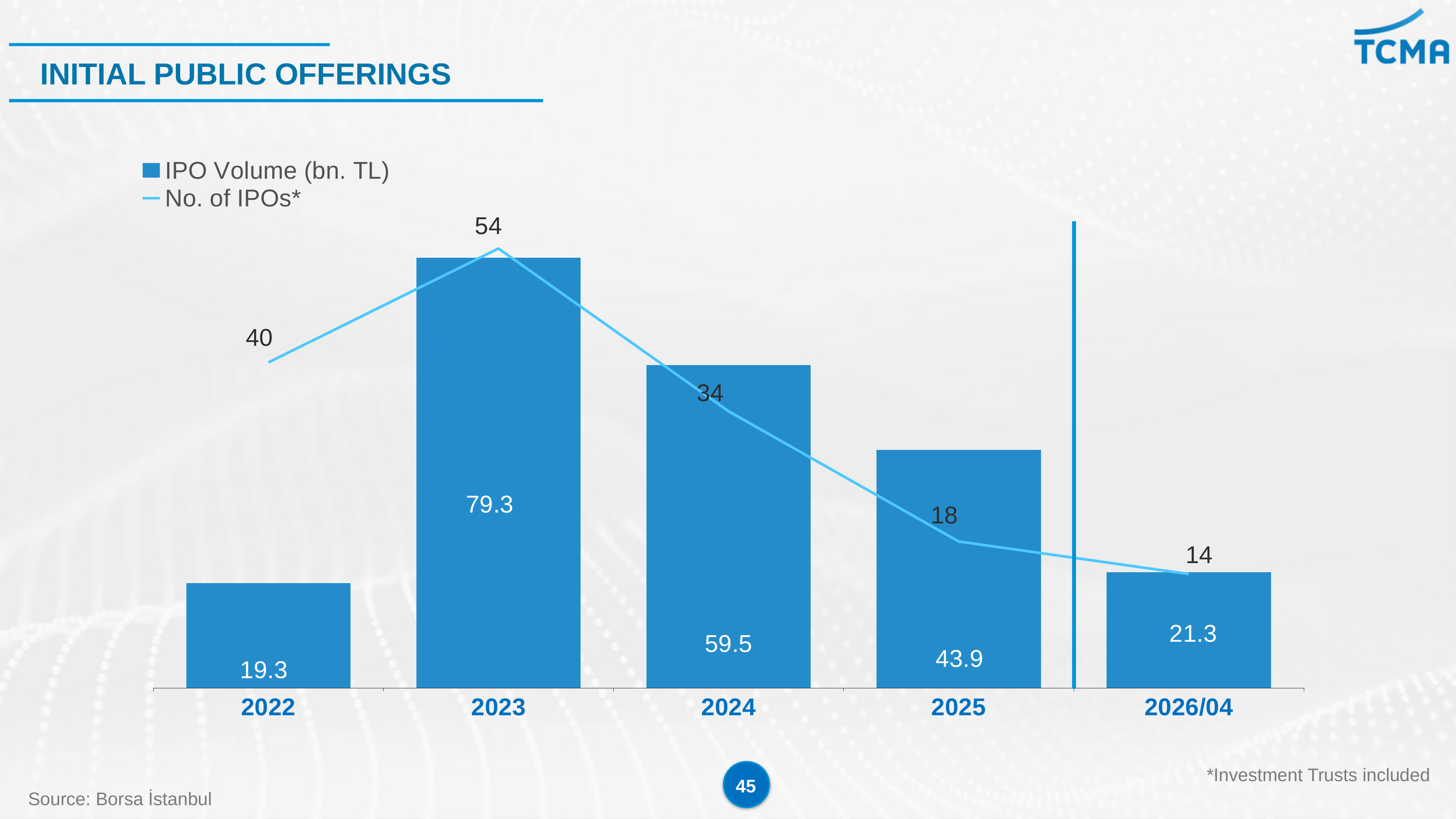
How many categories are shown on the x axis? 5 How many series does the legend list? 2 Which is larger, the IPO Volume (bn. TL) for 2022 or for 2026/04? 2026/04 Which category has the lowest No. of IPOs*? 2026/04 Does the No. of IPOs* rise or fall from 2023 to 2026/04? Fall What is the IPO Volume (bn. TL) for 2023? 79.3 What is the IPO Volume (bn. TL) for 2026/04? 21.3 What kind of chart is shown on the slide? Combined bar and line chart What is the No. of IPOs* for 2025? 18 What is the difference in IPO Volume (bn. TL) between 2024 and 2025? 15.6 What is the difference in No. of IPOs* between 2023 and 2022? 14 Which year has the highest IPO Volume (bn. TL)? 2023